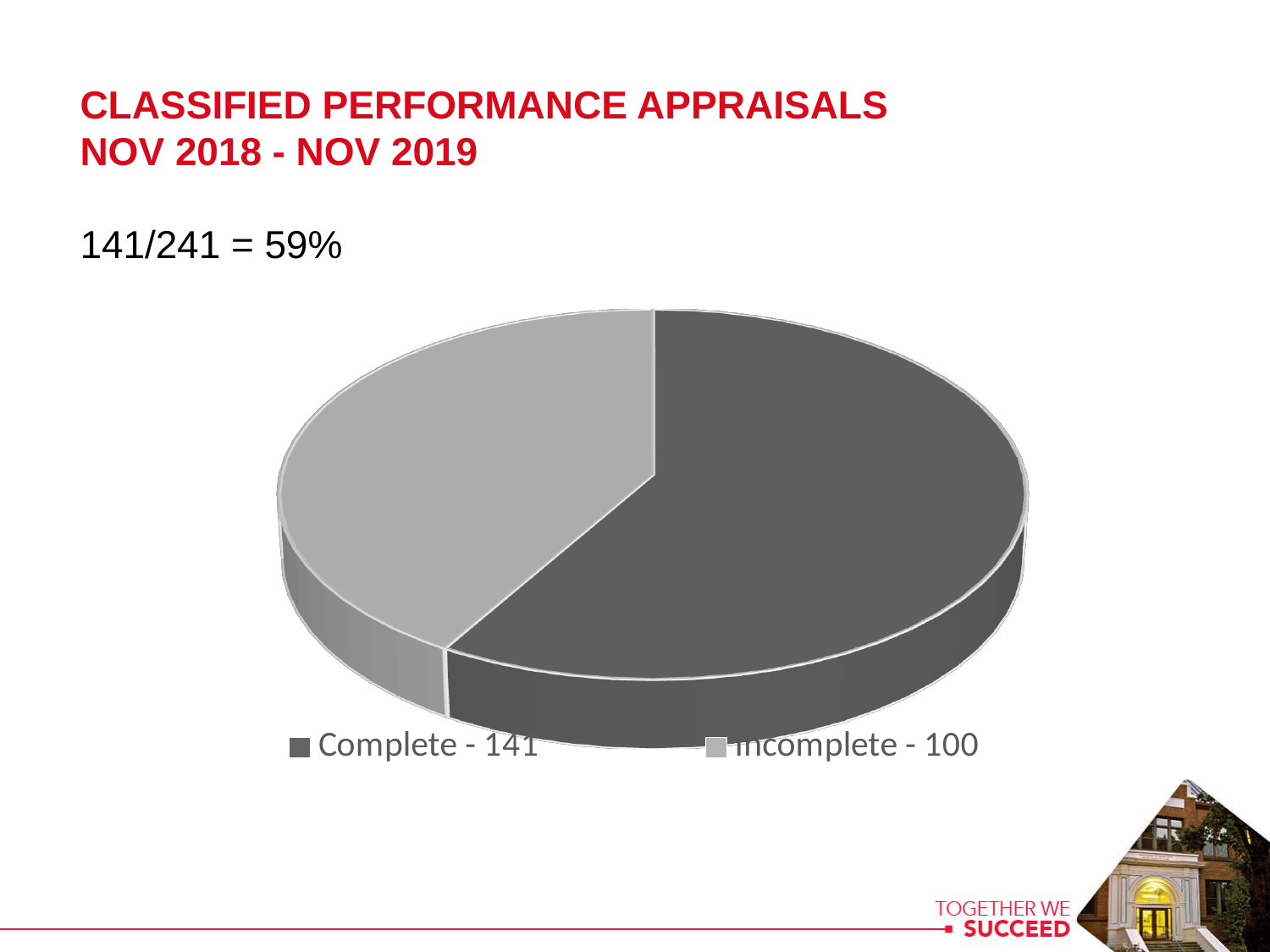
What is the total of the Complete and Incomplete values? 241 What value is shown for the Incomplete slice in the legend? 100 What is the title of the slide containing the pie chart? CLASSIFIED PERFORMANCE APPRAISALS NOV 2018 - NOV 2019 What kind of chart is shown on the slide? pie chart Which slice is shown in the lighter grey colour? Incomplete - 100 What is the difference between the Complete and Incomplete values? 41 How many slices does the pie chart have? 2 What value is shown for the Complete slice in the legend? 141 What share of the total do the Complete appraisals represent, as stated on the slide? 59% How many entries does the legend list? 2 Which category has the smallest slice in the pie chart? Incomplete Which slice of the pie is larger, Complete or Incomplete? Complete